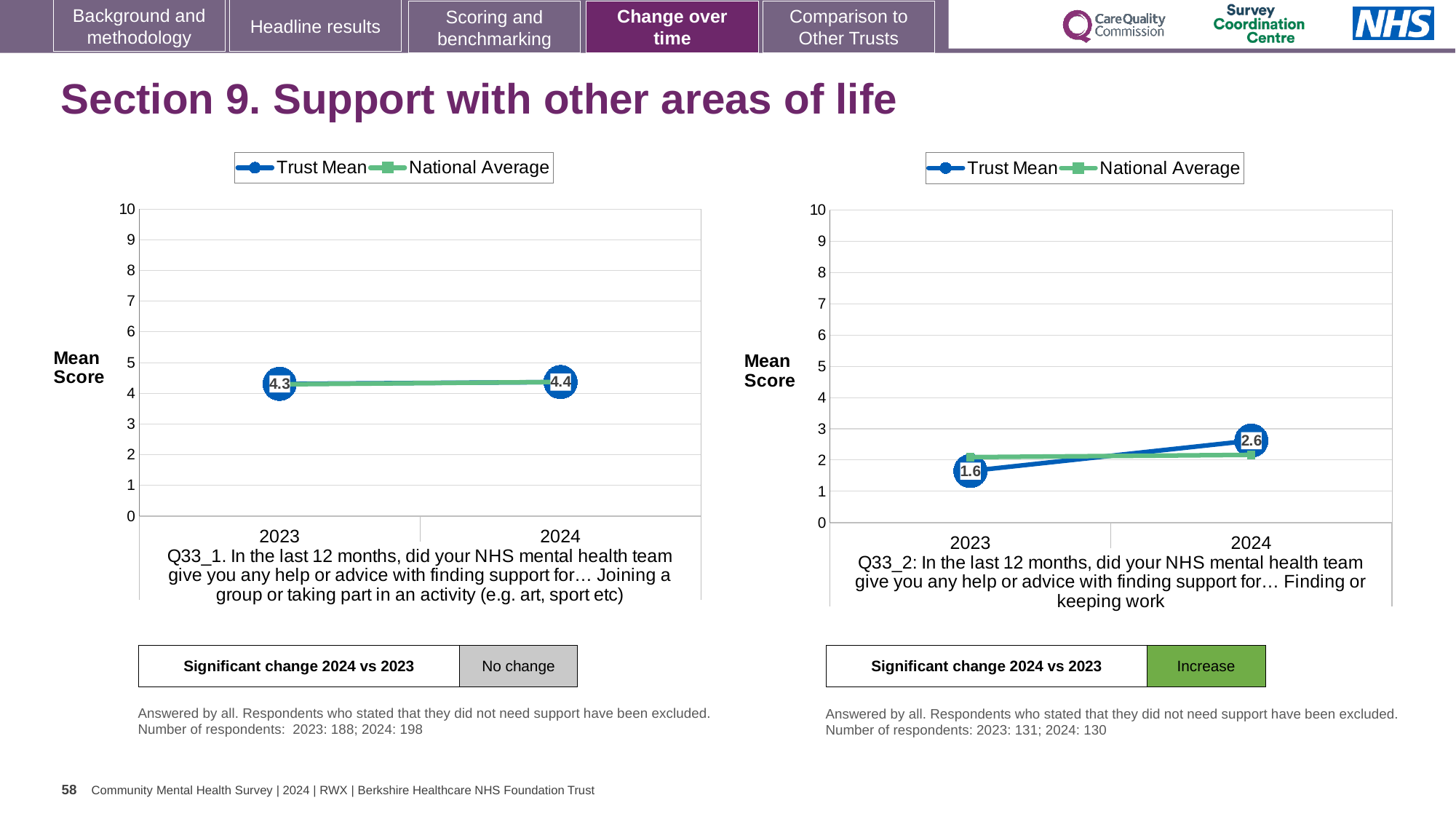
In the right chart (Q33_2), what is the Trust Mean score for 2023? 1.6 In the right chart (Q33_2), what is the Trust Mean score for 2024? 2.6 In the right chart (Q33_2), by how much did the Trust Mean change from 2023 to 2024? 1.0 In the left chart (Q33_1), what is the Trust Mean score for 2024? 4.4 How many series does the legend of the left chart (Q33_1) list? 2 In the right chart (Q33_2), does the Trust Mean rise or fall from 2023 to 2024? rise What kind of chart is the left chart (Q33_1)? line chart How many years are plotted on the x axis of the right chart (Q33_2)? 2 What does the box below the right chart (Q33_2) say about the significant change 2024 vs 2023? Increase In the right chart (Q33_2), which year has the higher Trust Mean, 2023 or 2024? 2024 In the left chart (Q33_1), what is the Trust Mean score for 2023? 4.3 In the right chart (Q33_2), is the National Average value for 2024 greater or less than 3? less